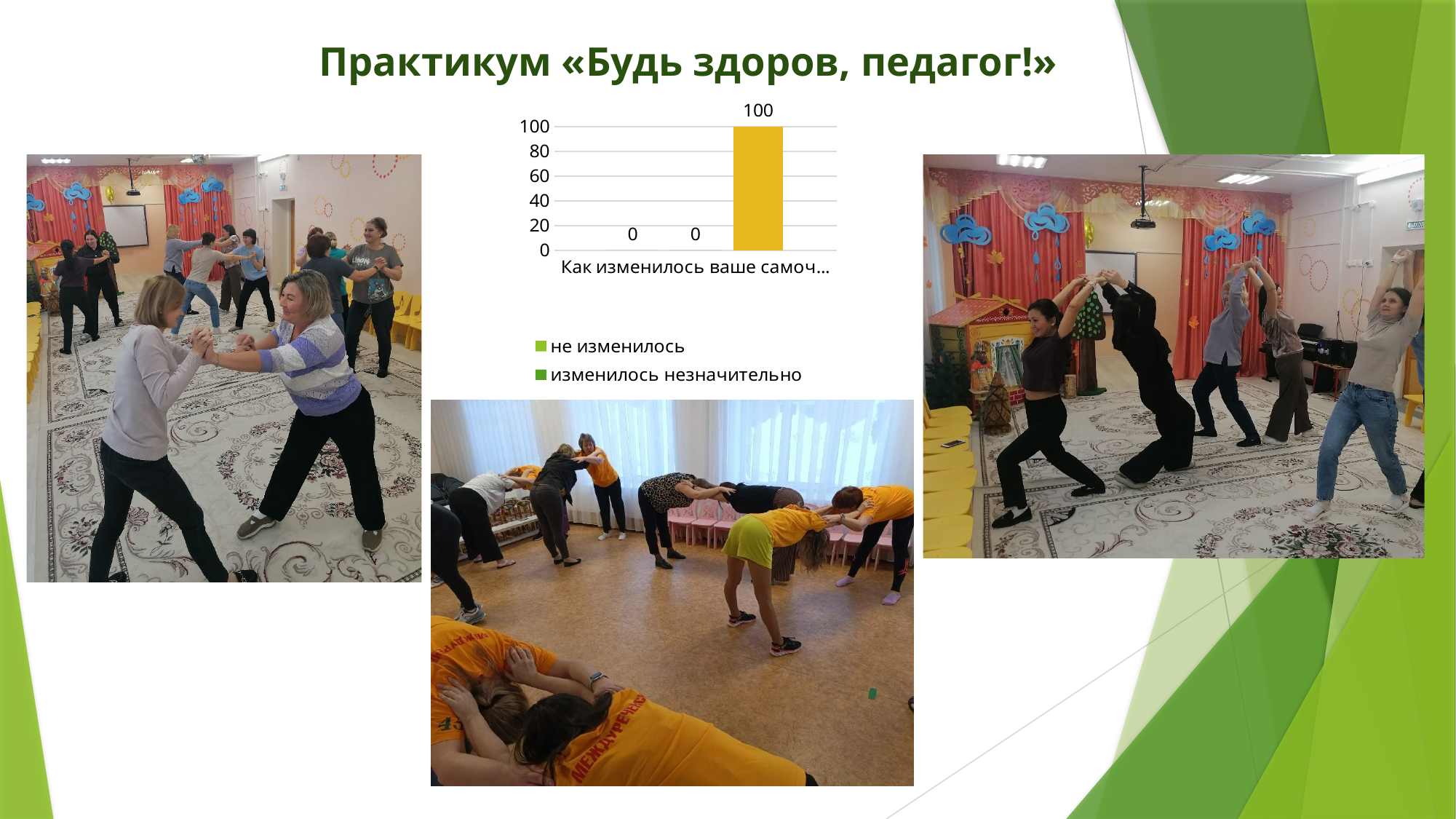
What is the value for the series "не изменилось"? 0 Is the value of the tallest bar greater or less than 80? greater What colour is the tallest bar in the chart? yellow What is the value for the series "изменилось незначительно"? 0 How many data labels (bars) are shown in the chart? 3 What is the maximum value shown on the chart's vertical axis? 100 What is the difference between the tallest bar's value and the value for "не изменилось"? 100 How many series entries are visible in the chart's legend? 2 What kind of chart is shown on the slide? bar chart What is the highest value shown in the chart? 100